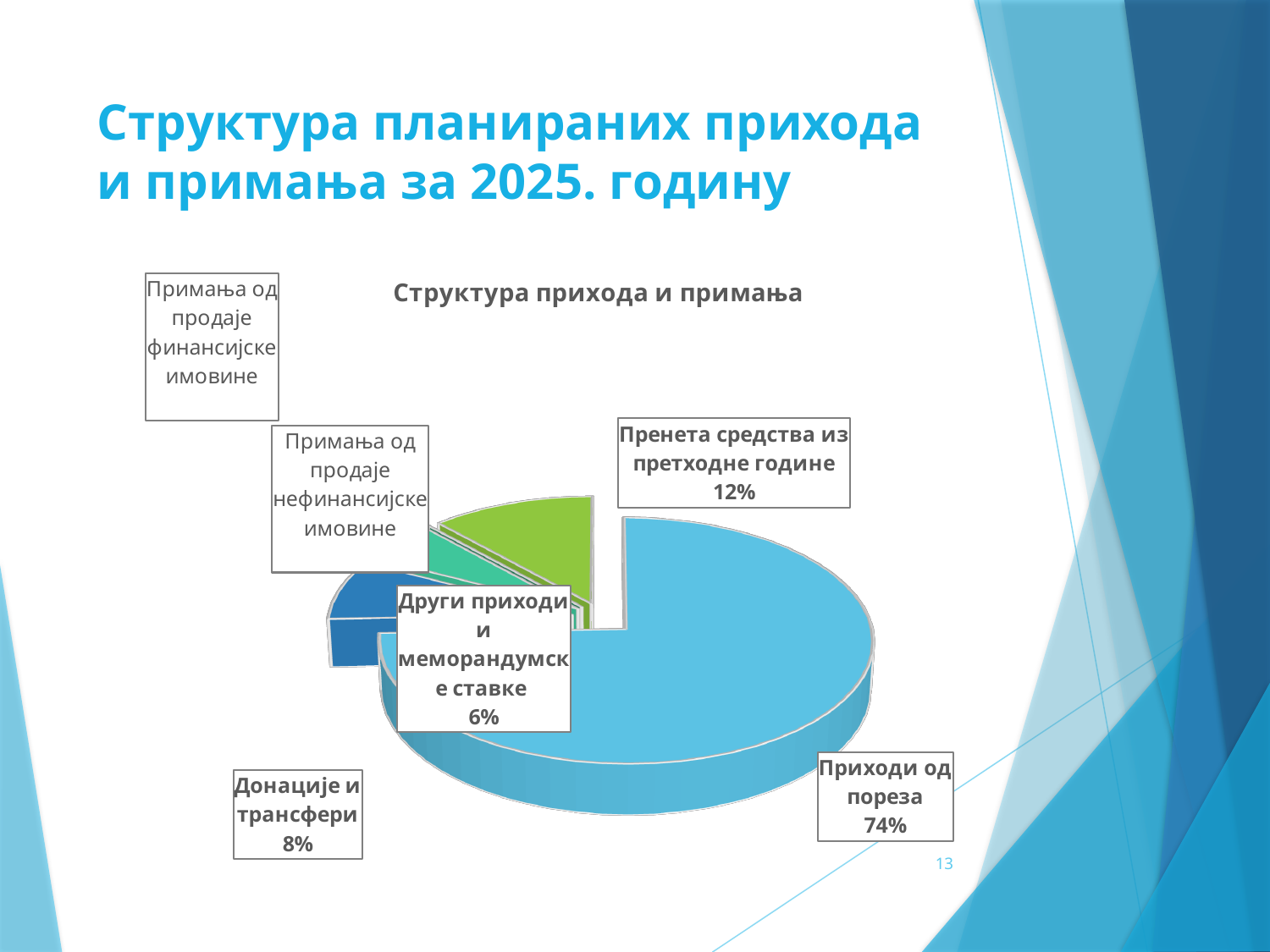
What share of the pie is Приходи од пореза? 74% What share of the pie is Донације и трансфери? 8% What kind of chart is shown on the slide? pie chart How many categories are shown in the pie chart? 6 What share of the pie is Други приходи и меморандумске ставке? 6% Which is larger: Пренета средства из претходне године or Донације и трансфери? Пренета средства из претходне године Which is larger: Други приходи и меморандумске ставке or Донације и трансфери? Донације и трансфери Which category has the largest share of the pie? Приходи од пореза What is the difference in percentage points between Донације и трансфери and Други приходи и меморандумске ставке? 2 What is the title of the chart? Структура прихода и примања What share of the pie is Пренета средства из претходне године? 12% What is the difference in percentage points between Приходи од пореза and Пренета средства из претходне године? 62